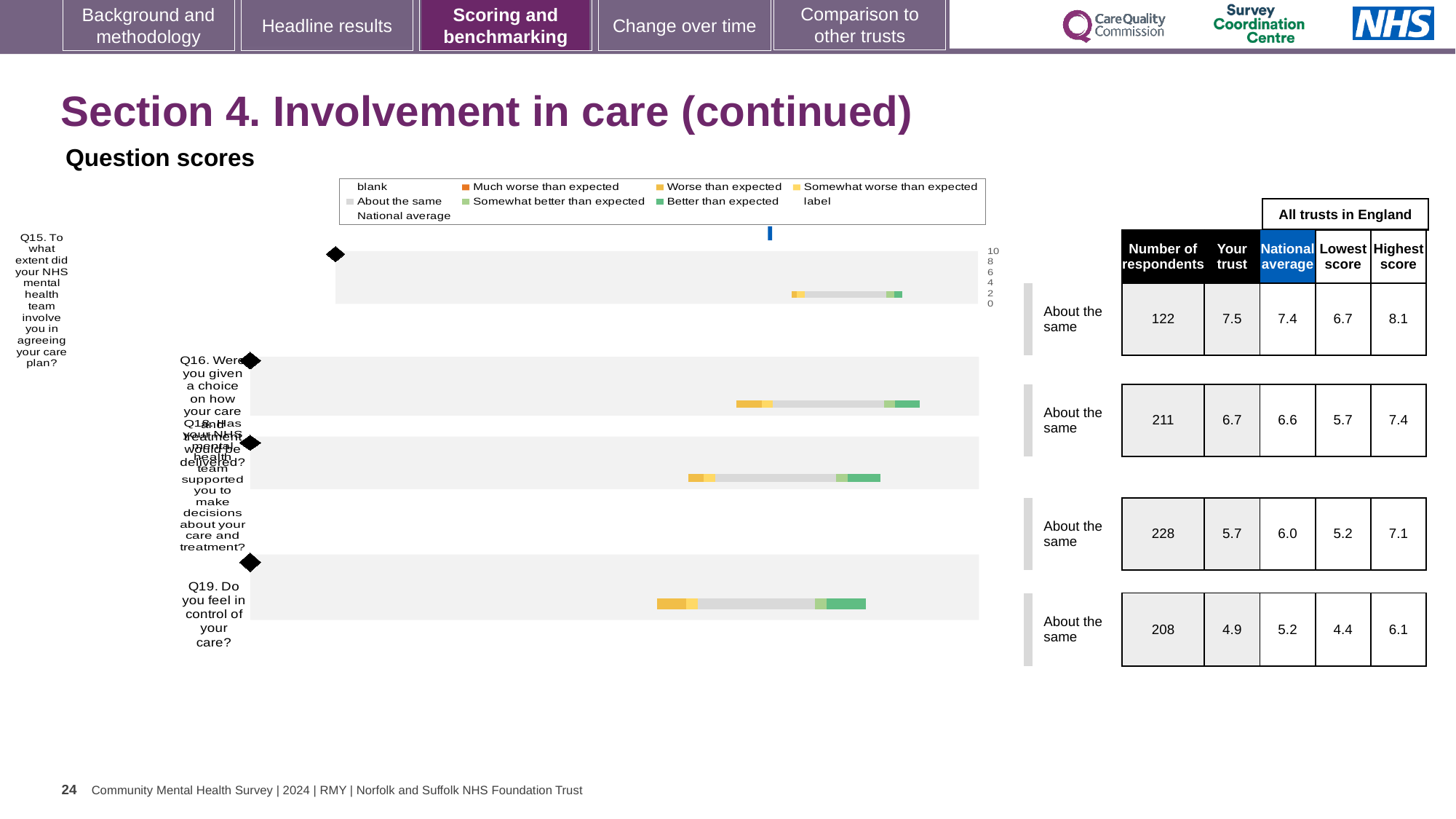
What benchmark category is shown next to each of the four questions in the chart? About the same What is the national average score for Q19 (feeling in control of your care)? 5.2 What is the highest score across all trusts in England for Q18 (supported to make decisions about care and treatment)? 7.1 Which question has the highest 'Your trust' score? Q15 How many questions (categories) are plotted in the question scores chart? 4 What is the 'Your trust' score for Q15 (involving you in agreeing your care plan)? 7.5 Which question has the lowest 'Your trust' score? Q19 For Q16, which is larger: the 'Your trust' score or the national average? Your trust What is the difference between the highest score (8.1) and the lowest score (6.7) for Q15? 1.4 What kind of chart is used to show the question scores on this slide? bar chart How many respondents answered Q16 (given a choice on how care and treatment would be delivered)? 211 Which question had the largest number of respondents? Q18